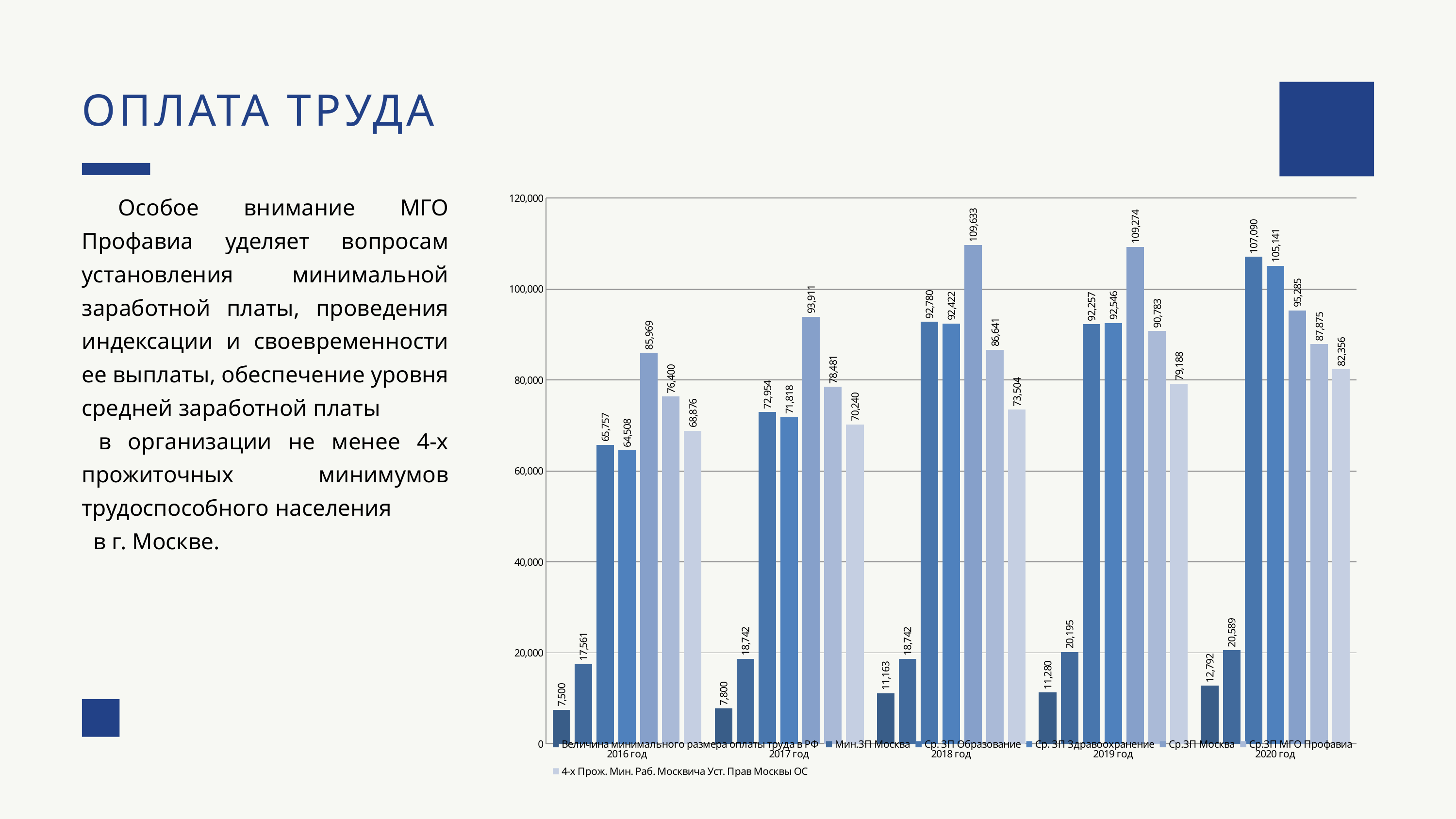
In 2020 год, which is larger: 'Ср. ЗП Образование' or 'Ср.ЗП Москва'? Ср. ЗП Образование What is the difference between 'Мин.ЗП Москва' in 2020 год and in 2016 год? 3,028 What is the value of 'Величина минимального размера оплаты труда в РФ' for 2016 год? 7,500 What is the value of 'Ср.ЗП Москва' for 2018 год? 109,633 What is the value of '4-х Прож. Мин. Раб. Москвича Уст. Прав Москвы ОС' for 2020 год? 82,356 What kind of chart is shown on the slide? Bar chart In which year is the value of 'Ср. ЗП Здравоохранение' the lowest? 2016 год How many series does the chart legend list? 7 Does the value of 'Величина минимального размера оплаты труда в РФ' rise or fall from 2016 год to 2020 год? Rise How many year groups are shown on the x axis of the chart? 5 In which year is the value of 'Ср.ЗП МГО Профавиа' the highest? 2019 год Is the value of 'Ср. ЗП Образование' for 2017 год greater or less than 80,000? less